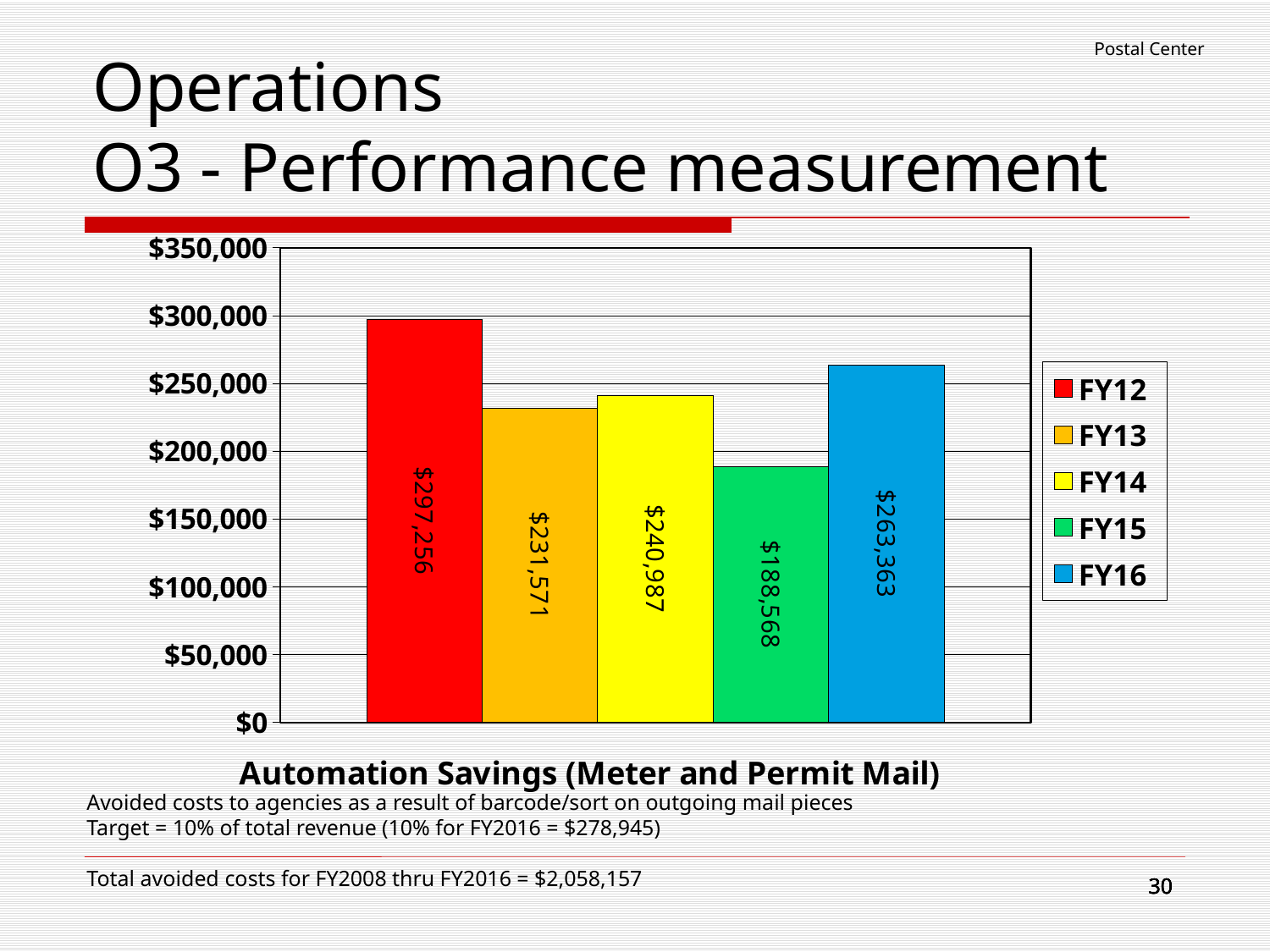
What kind of chart is shown on the slide? bar chart Which fiscal year has the lowest automation savings? FY15 What is the value for FY12? $297,256 Is the value for FY13 greater or less than $250,000? less Which fiscal year has the highest automation savings? FY12 What is the difference between the FY12 and FY15 values? $108,688 What is the value for FY16? $263,363 Which is larger, the value for FY16 or the value for FY14? FY16 What is the title of the chart? Automation Savings (Meter and Permit Mail) How many fiscal years are shown in the chart? 5 What is the difference between the FY14 and FY13 values? $9,416 What is the value for FY15? $188,568